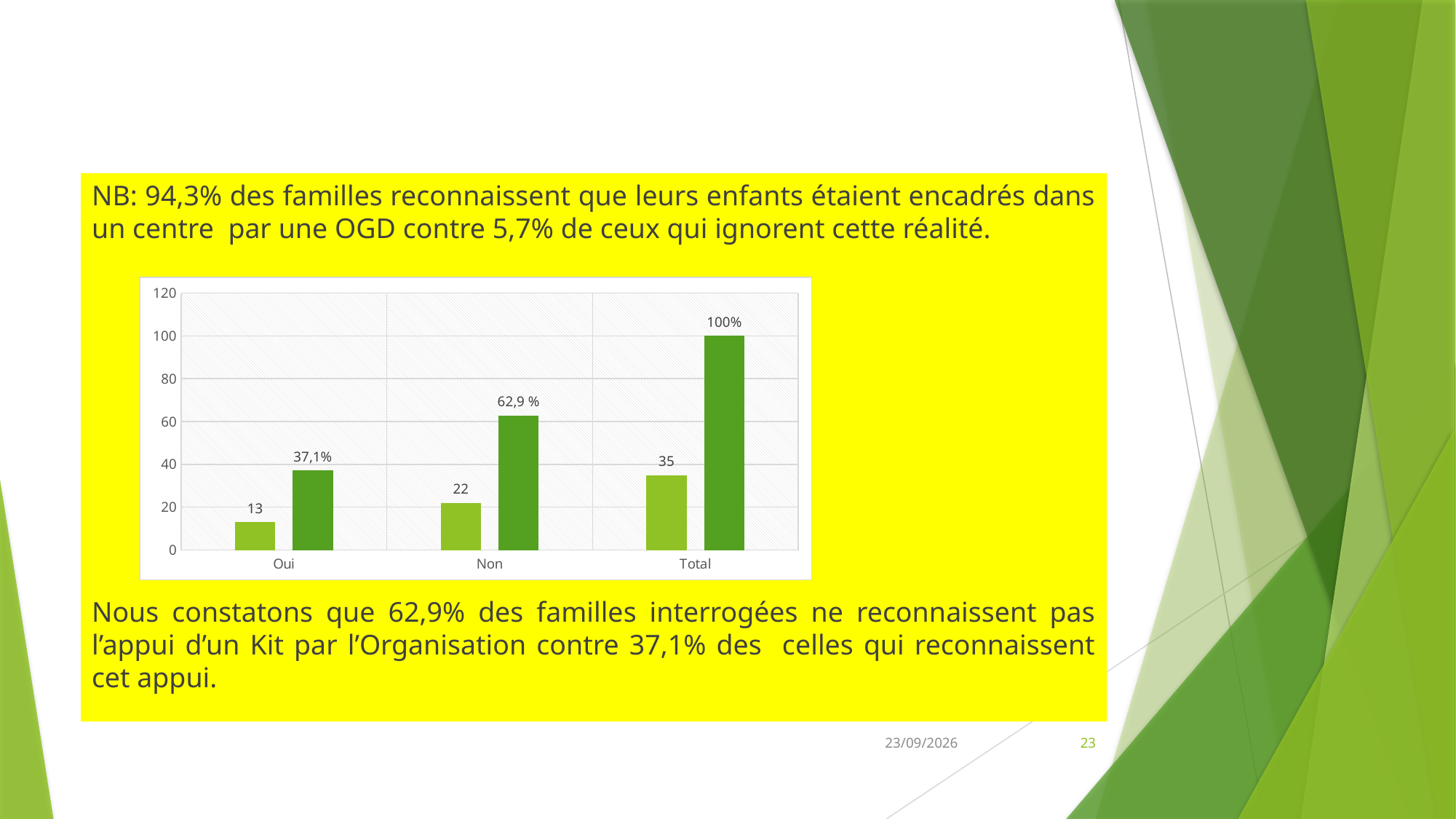
What kind of chart is shown on the slide? bar chart What is the value of the dark green bar for Total? 100% Which category has the highest dark green bar? Total Which is larger, the light green bar for Non or the light green bar for Oui? Non What is the difference between the light green bars for Non and Oui? 9 What is the value of the light green bar for Oui? 13 Which category has the lowest light green bar? Oui What is the value of the dark green bar for Non? 62,9 % How many categories are shown on the x axis of the chart? 3 What is the value of the dark green bar for Oui? 37,1% What is the value of the light green bar for Non? 22 What is the value of the light green bar for Total? 35